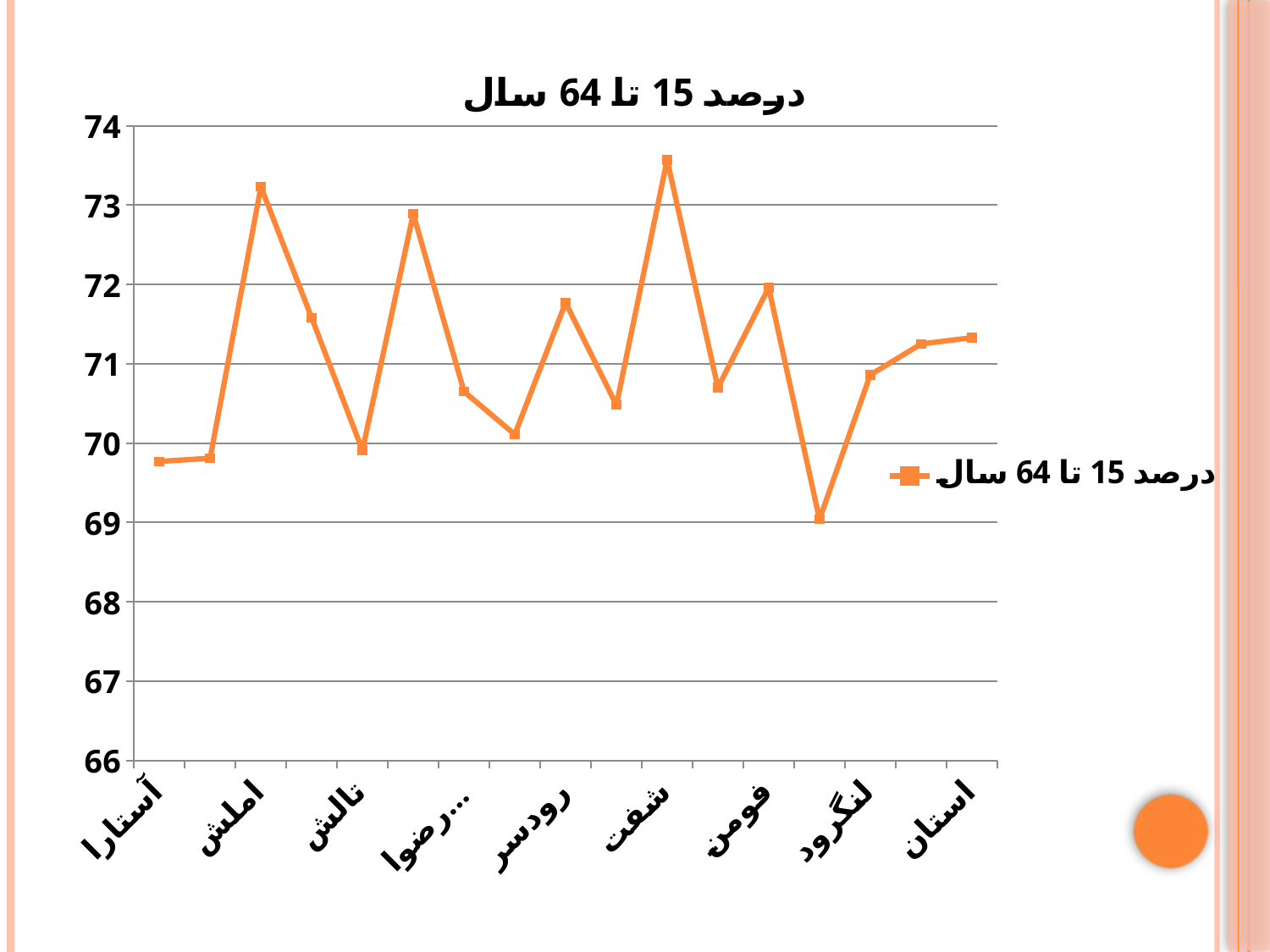
Is the value for استان greater or less than 71? greater Is the value for شفت greater or less than 73? greater What is the title of the chart? درصد 15 تا 64 سال How many series does the legend list? 1 How many data points are plotted on the line? 17 Which is larger, the value for فومن or the value for لنگرود? فومن Is the value for آستارا greater or less than 70? less Which labelled category has the highest value? شفت What kind of chart is shown on the slide? line chart Which is larger, the value for املش or the value for تالش? املش